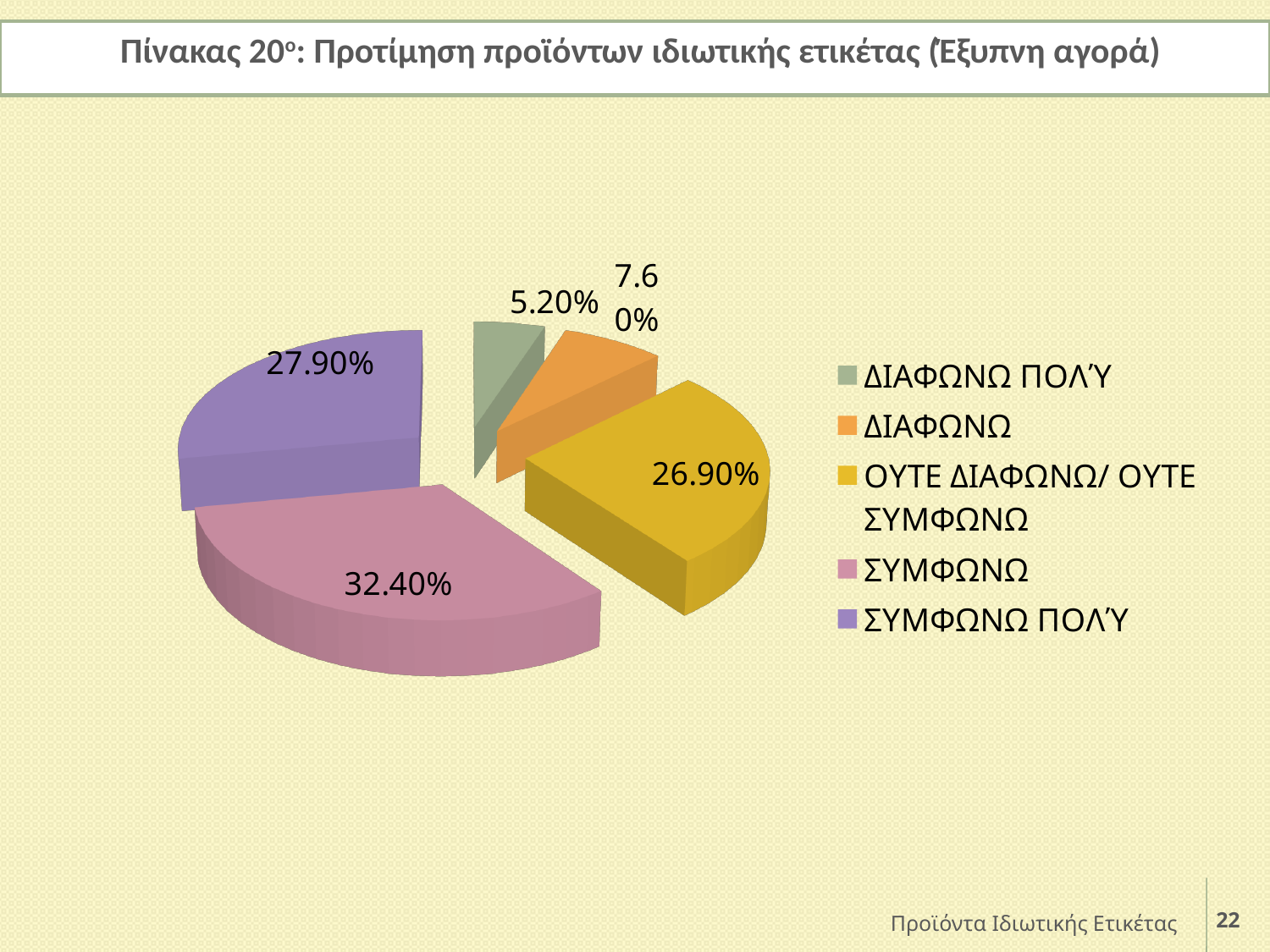
What is the value for ΔΙΑΦΩΝΩ ΠΟΛΎ? 5.20% What kind of chart is shown on the slide? pie chart Which category has the smallest share of the pie? ΔΙΑΦΩΝΩ ΠΟΛΎ What is the difference between the values for ΣΥΜΦΩΝΩ and ΣΥΜΦΩΝΩ ΠΟΛΎ? 4.50% Which is larger, the value for ΣΥΜΦΩΝΩ ΠΟΛΎ or the value for ΟΥΤΕ ΔΙΑΦΩΝΩ/ ΟΥΤΕ ΣΥΜΦΩΝΩ? ΣΥΜΦΩΝΩ ΠΟΛΎ How many categories does the pie chart have? 5 What is the value for ΔΙΑΦΩΝΩ? 7.60% Which category has the largest share of the pie? ΣΥΜΦΩΝΩ What is the value for ΣΥΜΦΩΝΩ? 32.40% What is the value for ΣΥΜΦΩΝΩ ΠΟΛΎ? 27.90% What is the value for ΟΥΤΕ ΔΙΑΦΩΝΩ/ ΟΥΤΕ ΣΥΜΦΩΝΩ? 26.90% What colour is the slice for ΣΥΜΦΩΝΩ ΠΟΛΎ? purple